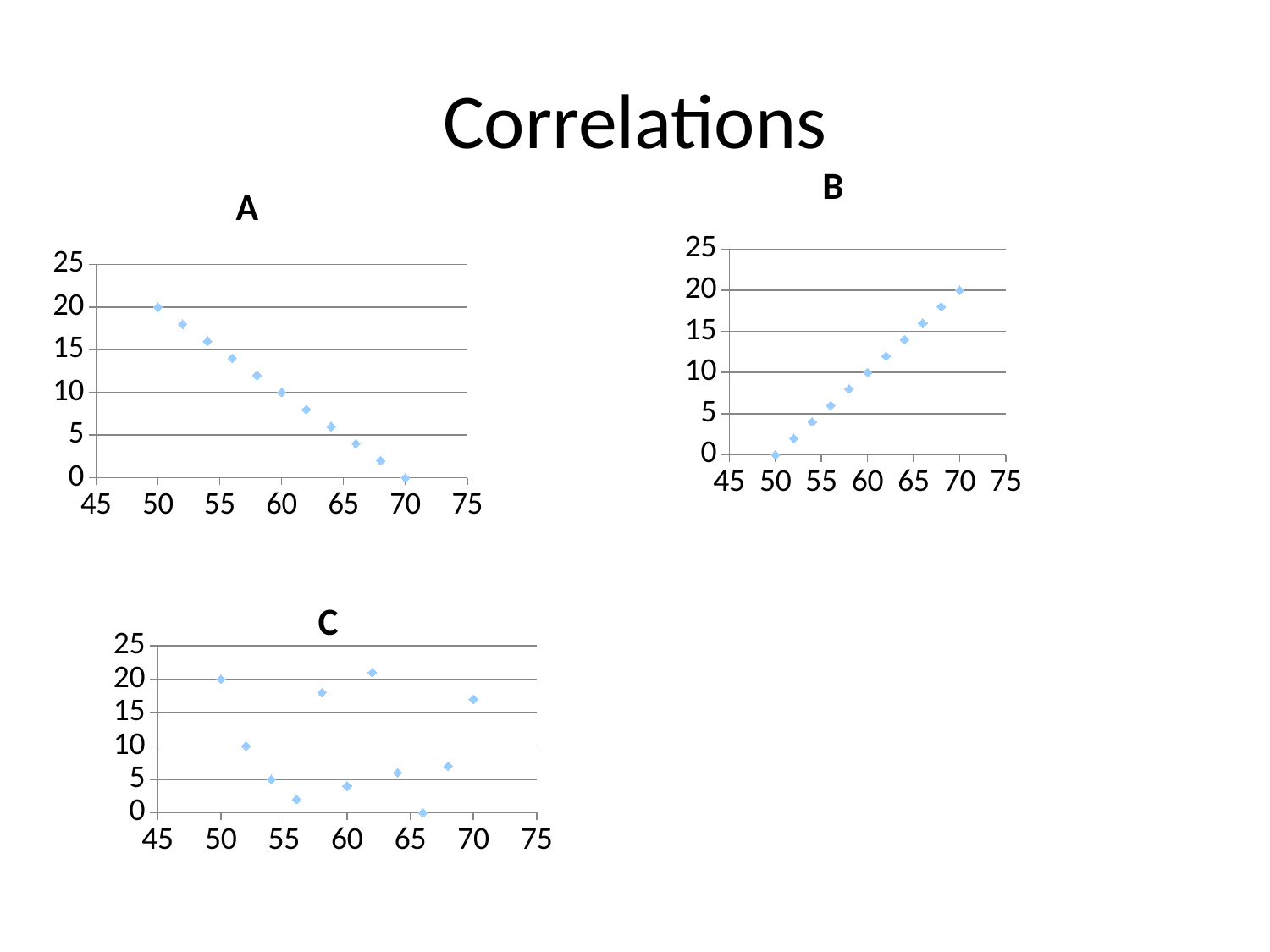
In chart A, what is the y value of the point at x = 50? 20 In chart A, what is the y value of the point at x = 70? 0 How many points are plotted in chart C? 11 In chart C, what is the y value of the point at x = 50? 20 In chart B, is the y value of the point at x = 66 greater or less than 15? greater How many charts are shown on the slide? 3 In chart B, do the y values rise or fall as x increases? rise In chart B, what is the y value of the point at x = 60? 10 In chart A, do the y values rise or fall as x increases? fall In chart A, which x value has the highest y value? 50 What kind of chart is chart A? scatter chart In chart B, which x value has the lowest y value? 50